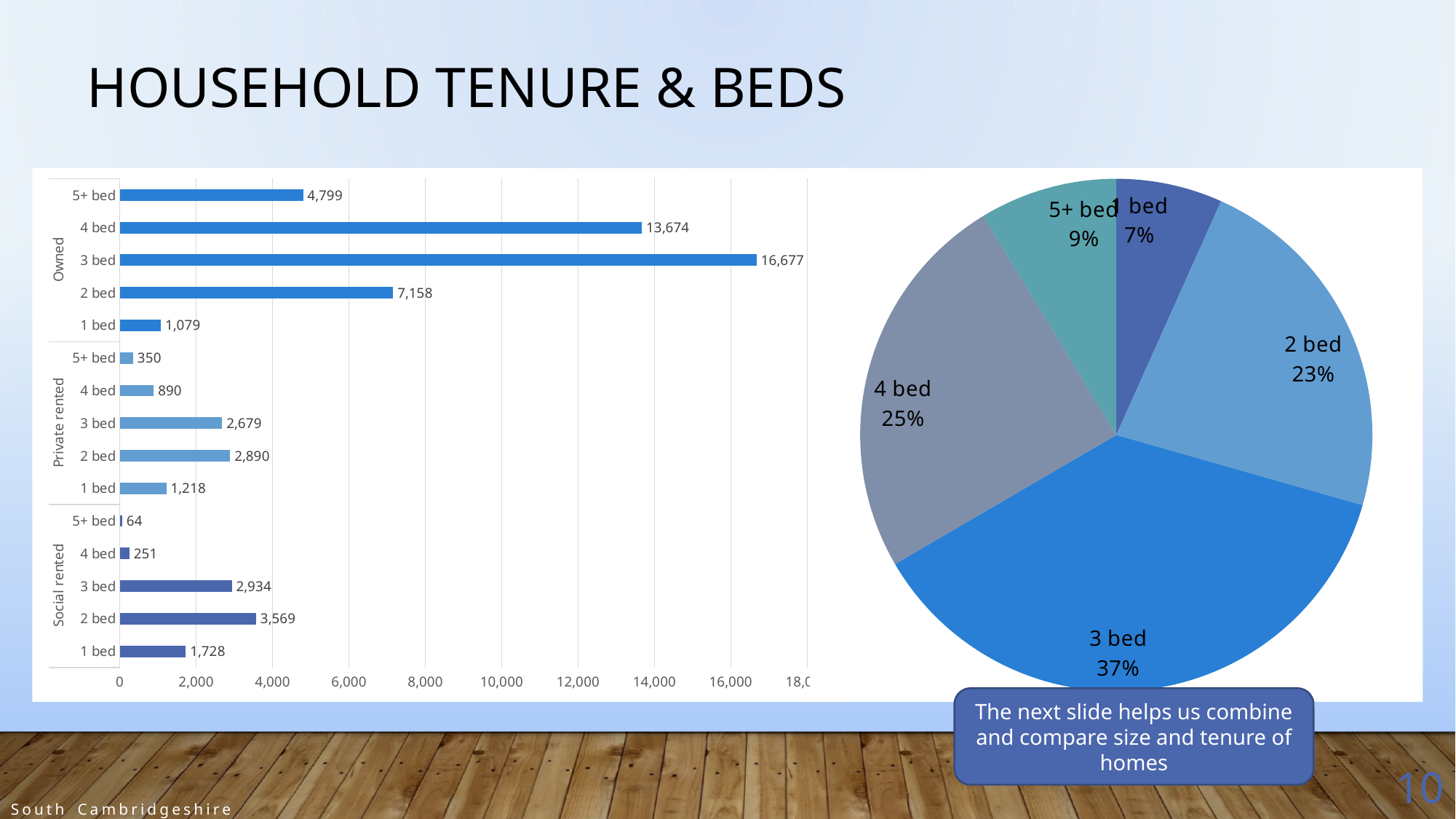
In the pie chart on the right, which slice is the smallest? 1 bed In the bar chart on the left, what is the difference between the Owned 4 bed value and the Owned 5+ bed value? 8,875 How many bars are plotted in the bar chart on the left? 15 What kind of chart is shown on the left of the slide? Bar chart How many slices does the pie chart on the right have? 5 In the pie chart on the right, what share do 3 bed homes have? 37% In the bar chart on the left, is the value for Owned 2 bed greater or less than 6,000? greater In the bar chart on the left, which bar has the lowest value? 5+ bed (Social rented) In the bar chart on the left, what is the value for 3 bed homes in the Owned group? 16,677 In the bar chart on the left, which is larger in the Private rented group: 2 bed or 3 bed? 2 bed In the bar chart on the left, what is the value for 2 bed homes in the Social rented group? 3,569 In the bar chart on the left, which bar has the highest value? 3 bed (Owned)